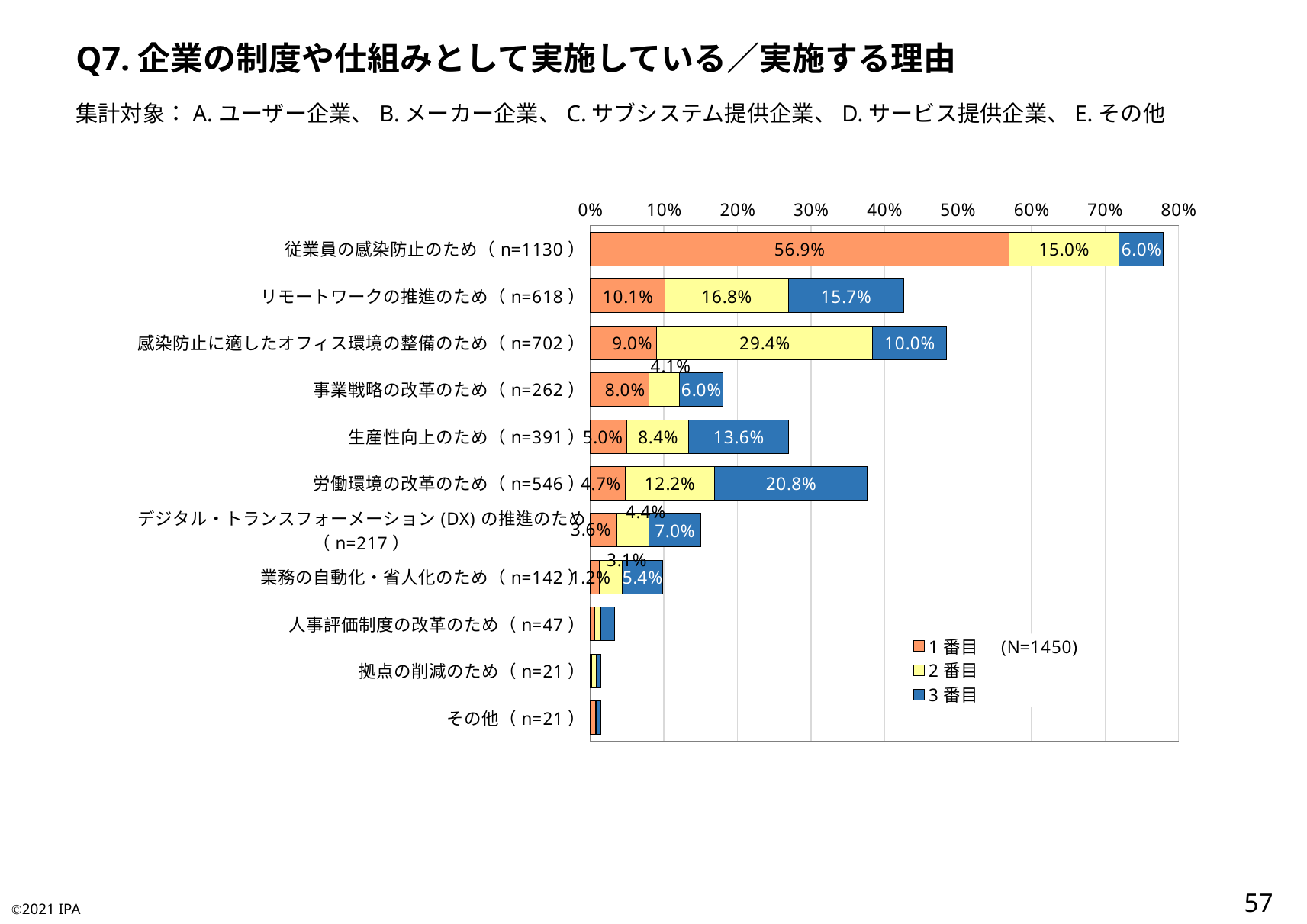
How many series does the legend list? 3 What is the difference between the 3番目 values for 生産性向上のため (n=391) and 事業戦略の改革のため (n=262)? 7.6% What is the 1番目 value for 従業員の感染防止のため (n=1130)? 56.9% What is the total of the stacked bar for リモートワークの推進のため (n=618)? 42.6% What is the 2番目 value for 感染防止に適したオフィス環境の整備のため (n=702)? 29.4% Which is larger: the 2番目 value for リモートワークの推進のため (n=618) or the 2番目 value for 労働環境の改革のため (n=546)? リモートワークの推進のため (n=618) Which category has the highest 1番目 value? 従業員の感染防止のため (n=1130) Is the total length of the bar for 感染防止に適したオフィス環境の整備のため (n=702) greater or less than 40%? greater What is the 3番目 value for 労働環境の改革のため (n=546)? 20.8% How many categories (reasons) are plotted in the chart? 11 What N value is shown next to the legend? N=1450 What type of chart is shown on the slide? Stacked bar chart